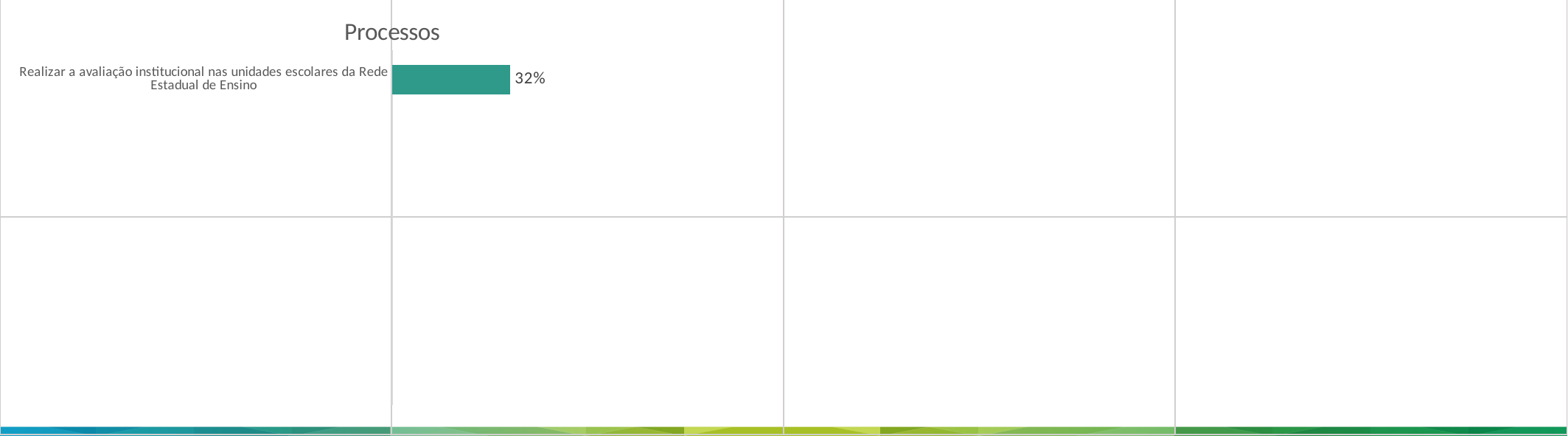
What is the title of the chart? Processos What colour is the bar in the chart? teal green How many bars does the chart contain? 1 What kind of chart is shown on the slide? bar chart Is the value for 'Realizar a avaliação institucional nas unidades escolares da Rede Estadual de Ensino' greater or less than 50%? less What is the value shown for 'Realizar a avaliação institucional nas unidades escolares da Rede Estadual de Ensino'? 32%